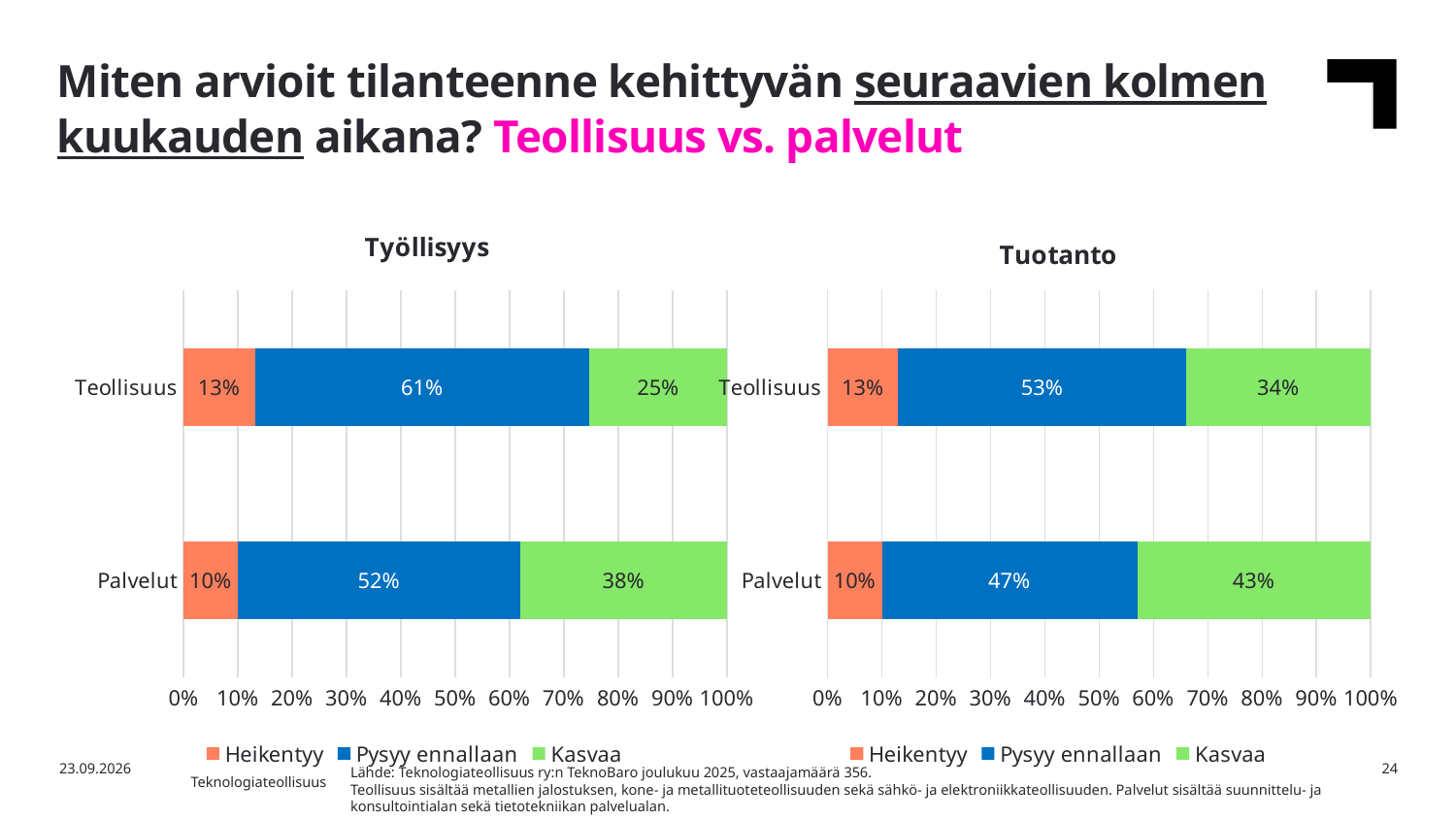
What kind of chart is the Tuotanto chart? Stacked bar chart In the Työllisyys chart, what is the Kasvaa value for Palvelut? 38% In the Tuotanto chart, what is the Heikentyy value for Palvelut? 10% How many categories are shown in the Työllisyys chart? 2 In the Työllisyys chart, what is the difference between the Kasvaa values for Palvelut and Teollisuus? 13 percentage points In the Tuotanto chart, which category has the larger Kasvaa value, Teollisuus or Palvelut? Palvelut In the Tuotanto chart, what is the total of the stacked bar for Palvelut? 100% In the Työllisyys chart, what is the Pysyy ennallaan value for Teollisuus? 61% In the Tuotanto chart, what is the Kasvaa value for Teollisuus? 34% How many series does the legend of the Tuotanto chart list? 3 In the Työllisyys chart, which category has the higher Pysyy ennallaan value? Teollisuus In the Tuotanto chart, what is the Pysyy ennallaan value for Palvelut? 47%